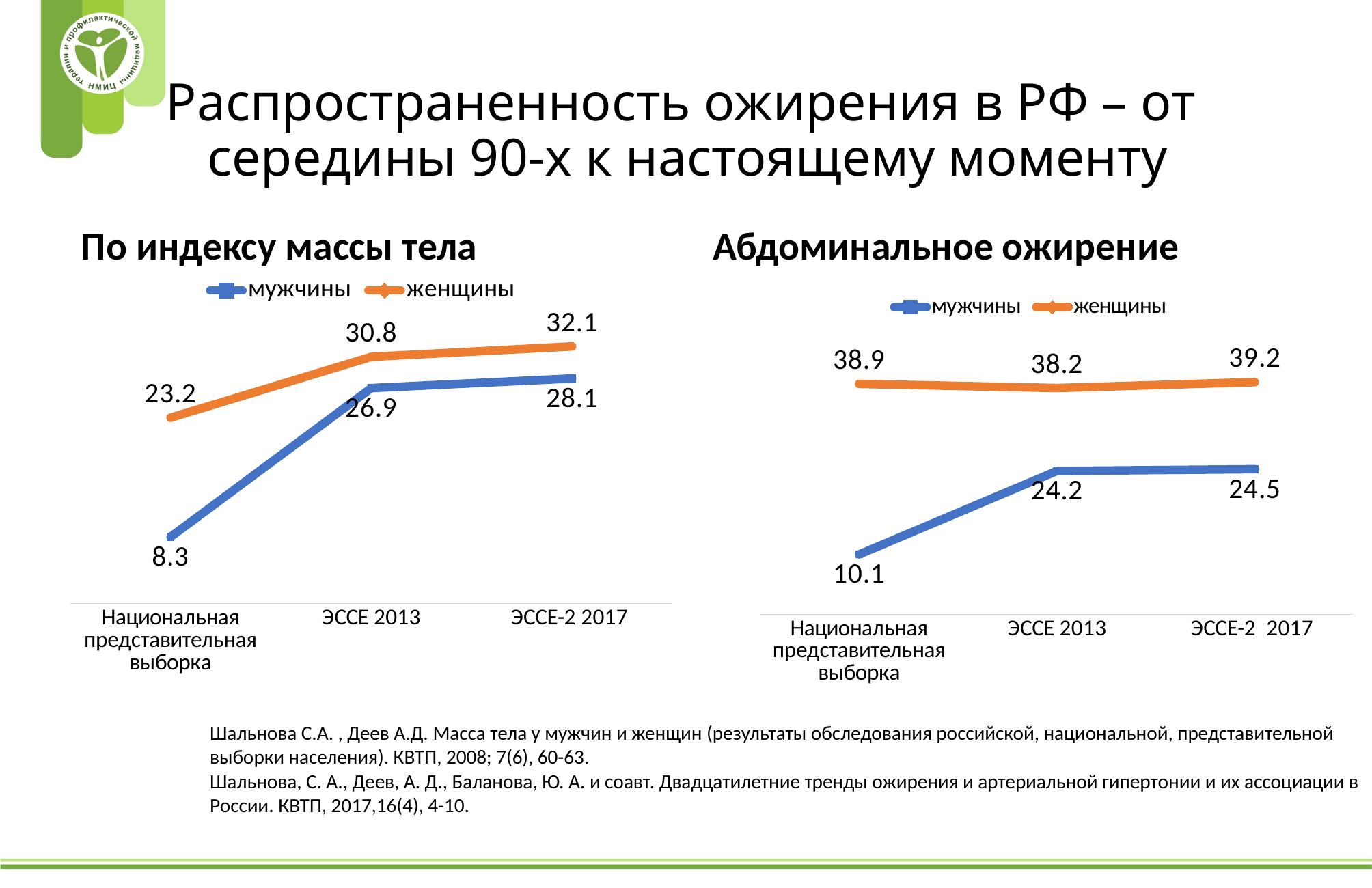
In the 'Абдоминальное ожирение' chart, at which category is the value for женщины highest? ЭССЕ-2 2017 In the 'По индексу массы тела' chart, does the value for мужчины rise or fall from Национальная представительная выборка to ЭССЕ-2 2017? rise In the 'По индексу массы тела' chart, what is the value for мужчины at ЭССЕ 2013? 26.9 In the 'По индексу массы тела' chart, which is larger at Национальная представительная выборка: мужчины or женщины? женщины In the 'По индексу массы тела' chart, at which category is the value for мужчины lowest? Национальная представительная выборка In the 'Абдоминальное ожирение' chart, what is the value for женщины at ЭССЕ 2013? 38.2 In the 'По индексу массы тела' chart, what is the difference between женщины and мужчины at ЭССЕ-2 2017? 4.0 In the 'По индексу массы тела' chart, what is the value for женщины at Национальная представительная выборка? 23.2 In the 'Абдоминальное ожирение' chart, what is the difference between мужчины at ЭССЕ 2013 and at Национальная представительная выборка? 14.1 What kind of chart is the 'По индексу массы тела' chart? line chart How many series does the legend of the 'Абдоминальное ожирение' chart list? 2 In the 'Абдоминальное ожирение' chart, what is the value for мужчины at ЭССЕ-2 2017? 24.5